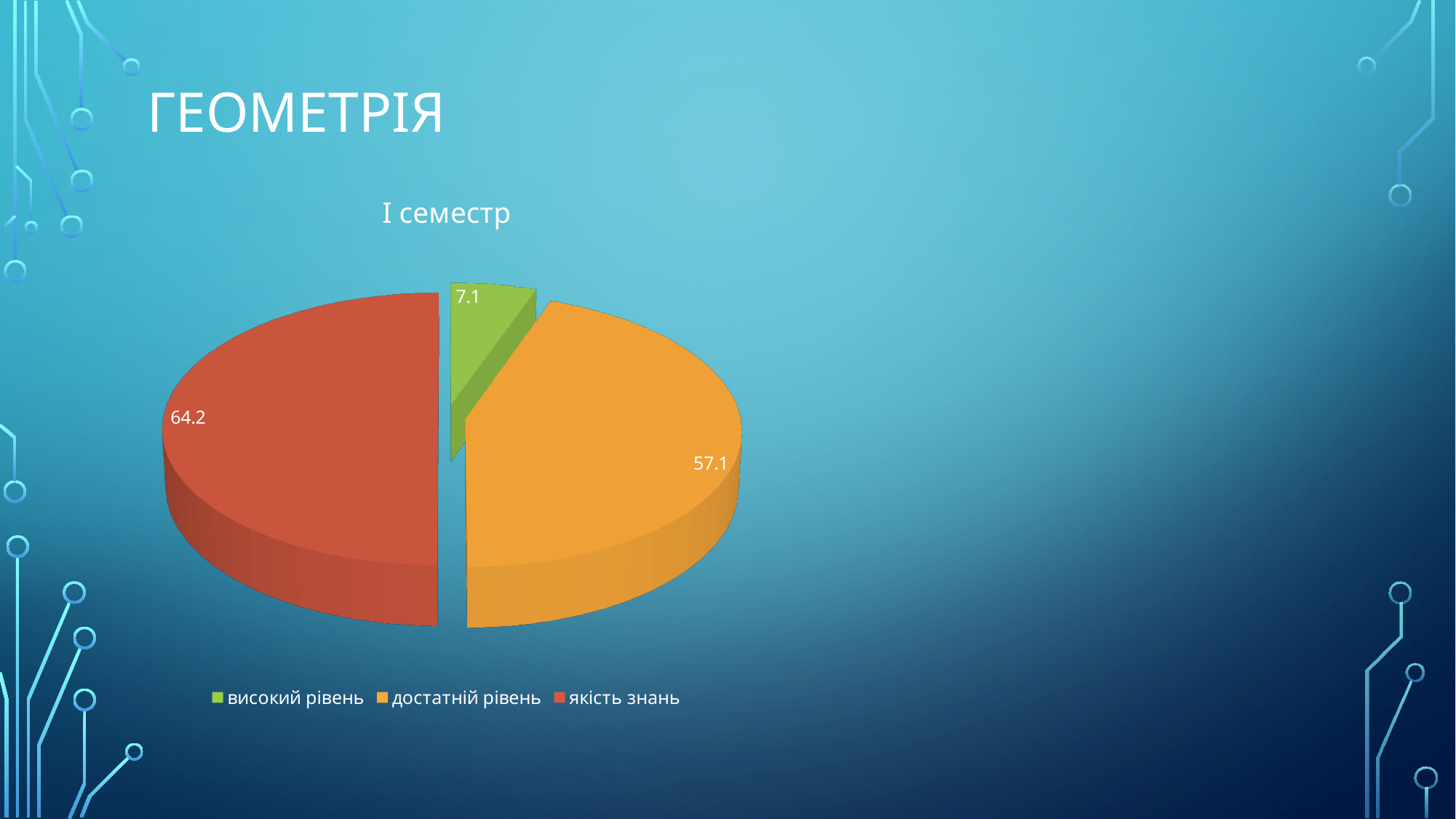
Which is larger, the value for достатній рівень or the value for високий рівень? достатній рівень What is the value for якість знань in the pie chart? 64.2 How many entries does the chart legend list? 3 What is the difference between the values for достатній рівень and високий рівень? 50 What kind of chart is shown on the slide? pie chart What is the difference between the values for якість знань and достатній рівень? 7.1 Which category has the smallest slice in the pie chart? високий рівень How many slices does the pie chart have? 3 Which category has the largest slice in the pie chart? якість знань What is the value for достатній рівень in the pie chart? 57.1 What is the title of the chart? І семестр What is the value for високий рівень in the pie chart? 7.1